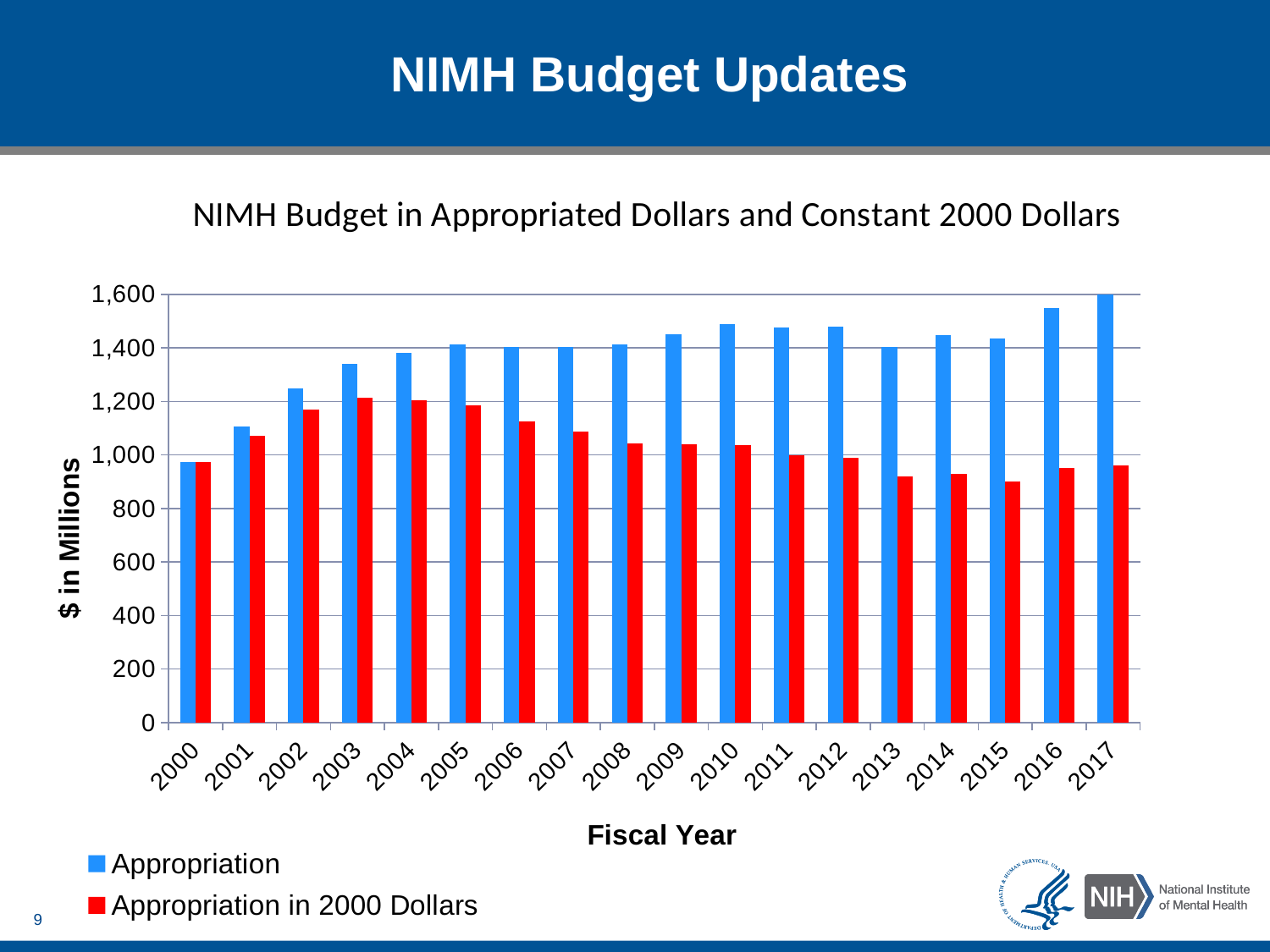
In which fiscal year is the Appropriation (blue) bar lowest? 2000 How many fiscal years are shown on the x axis? 18 In which fiscal year is the Appropriation (blue) bar highest? 2017 What kind of chart is shown on the slide? bar chart Is the Appropriation in 2000 Dollars value for 2015 greater or less than 1,000? less What is the label on the y axis? $ in Millions Which is larger: the Appropriation for 2016 or the Appropriation for 2013? 2016 How many series does the legend list? 2 Is the Appropriation in 2000 Dollars value for 2006 greater or less than 1,000? greater Is the Appropriation value for 2002 greater or less than 1,200? greater Does the Appropriation in 2000 Dollars series rise or fall from 2003 to 2015? fall